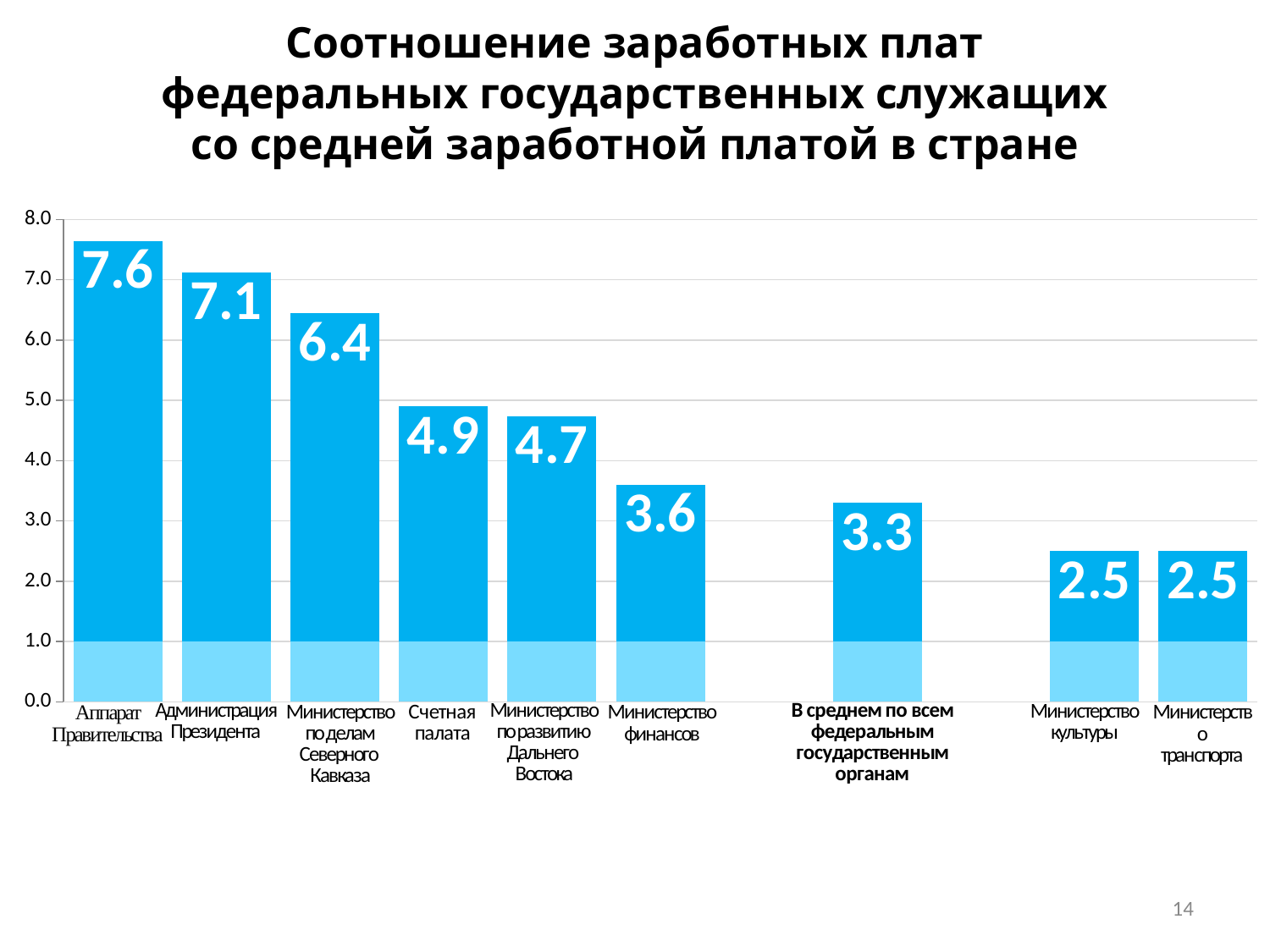
What is the value for Счетная палата? 4.9 What is the maximum value shown on the vertical axis? 8.0 What is the value shown for В среднем по всем федеральным государственным органам? 3.3 What kind of chart is shown on the slide? Bar chart Which is larger, the value for Министерство по развитию Дальнего Востока or the value for Министерство финансов? Министерство по развитию Дальнего Востока Which category has the highest value? Аппарат Правительства What is the value for Министерство финансов? 3.6 What is the lowest value shown on the chart? 2.5 What is the difference between the values for Аппарат Правительства and Администрация Президента? 0.5 What is the value for Аппарат Правительства? 7.6 What is the difference between the values for Министерство по делам Северного Кавказа and Министерство культуры? 3.9 How many bars are plotted on the chart? 9